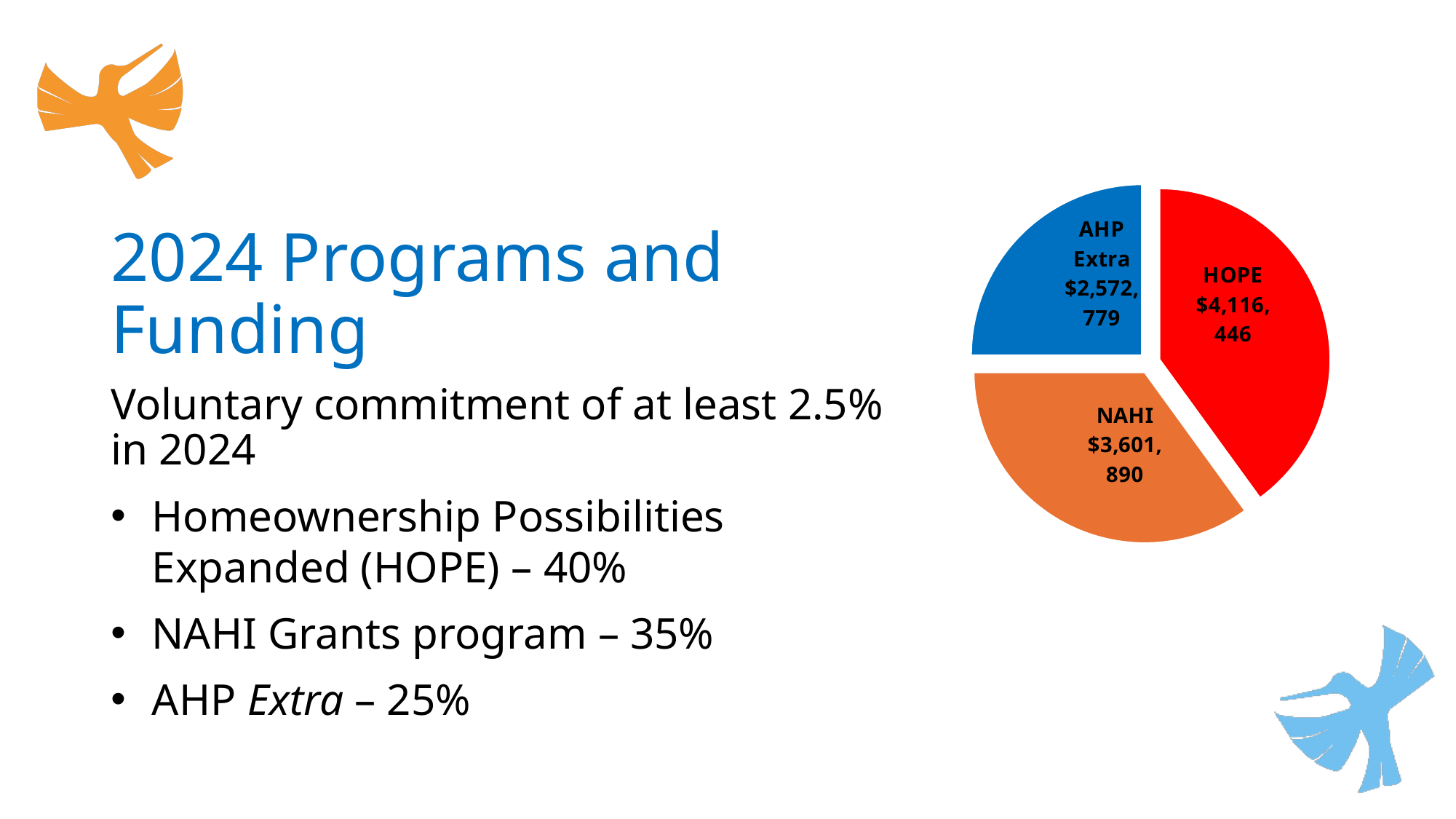
What is the difference between the HOPE and NAHI values in the pie chart? $514,556 What colour is the NAHI slice in the pie chart? orange Which slice of the pie chart has the smallest value? AHP Extra What share of the pie chart total does HOPE represent? 40% What is the value shown for NAHI in the pie chart? $3,601,890 What is the value shown for HOPE in the pie chart? $4,116,446 What kind of chart is shown on the slide? pie chart Which slice of the pie chart has the largest value? HOPE What is the value shown for AHP Extra in the pie chart? $2,572,779 Which is larger in the pie chart, NAHI or AHP Extra? NAHI How many slices does the pie chart have? 3 What is the difference between the NAHI and AHP Extra values in the pie chart? $1,029,111